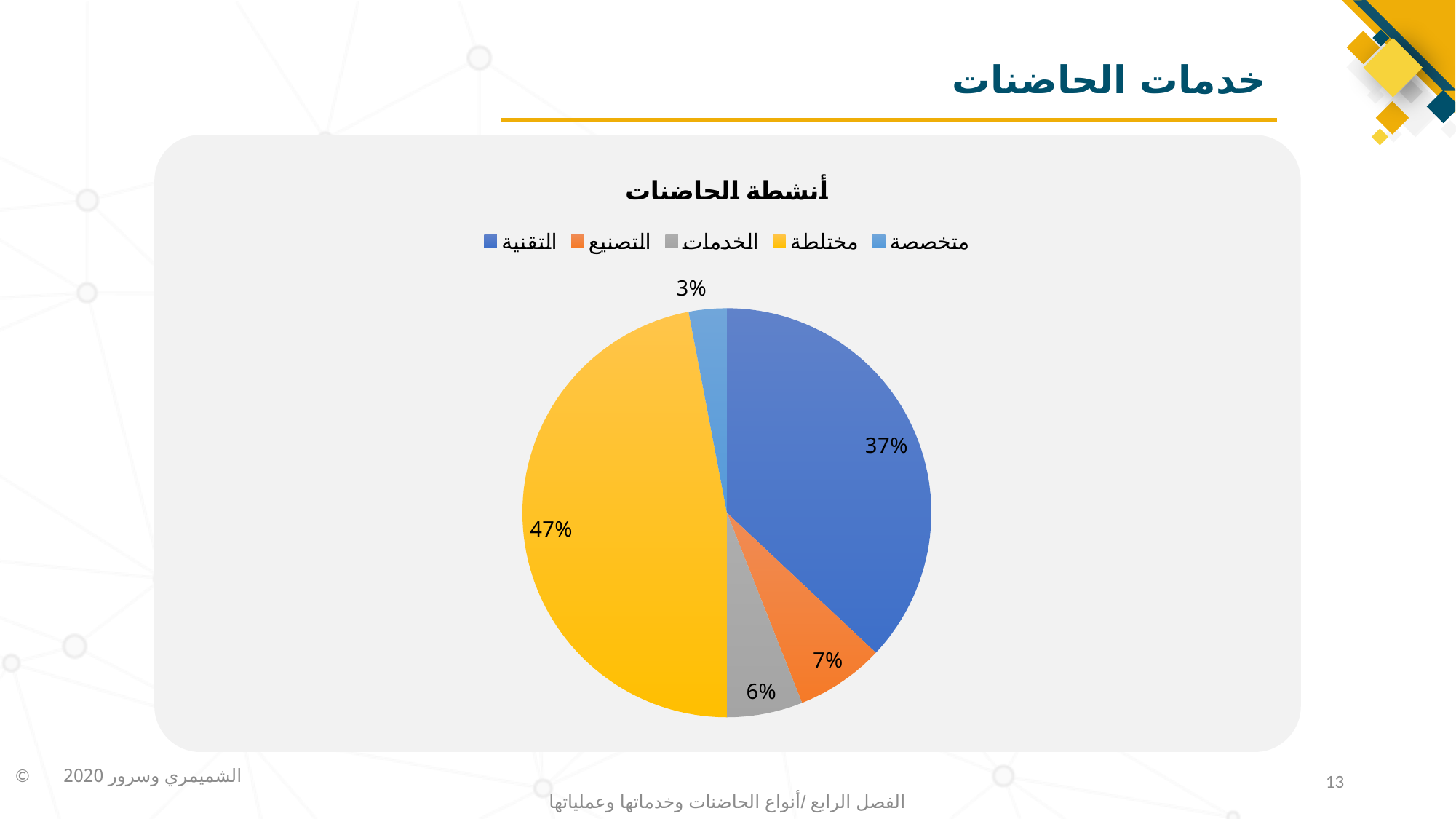
What share of the pie does التقنية hold? 37% What is the title of the chart? أنشطة الحاضنات Which category has the smallest slice of the pie? متخصصة What share of the pie does الخدمات hold? 6% What share of the pie does مختلطة hold? 47% What is the difference between the shares of مختلطة and التقنية? 10% Which is larger, the share of التصنيع or the share of الخدمات? التصنيع Which category has the largest slice of the pie? مختلطة How many categories does the legend list? 5 What share of the pie does متخصصة hold? 3% What share of the pie does التصنيع hold? 7% What type of chart is shown on the slide? Pie chart